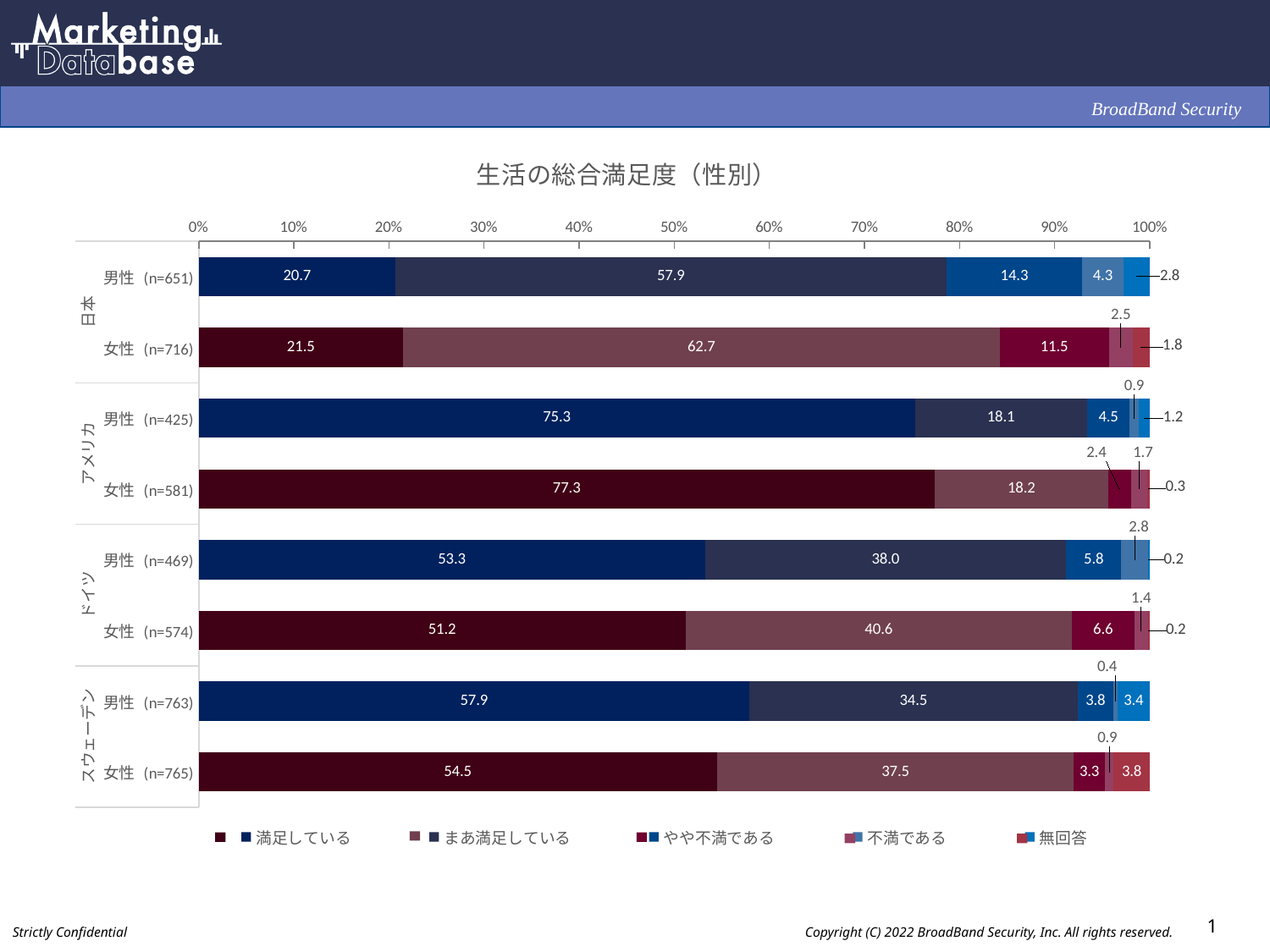
Which category has the highest 満足している value? アメリカ 女性 (n=581) What is the 満足している value for 日本 男性 (n=651)? 20.7 What is the difference between the 満足している values for ドイツ 男性 (n=469) and ドイツ 女性 (n=574)? 2.1 How many series does the legend list? 5 What is the やや不満である value for アメリカ 男性 (n=425)? 4.5 What type of chart is shown on the slide? Stacked bar chart What is the まあ満足している value for 日本 女性 (n=716)? 62.7 How many bars (category rows) are plotted in the chart? 8 Which category has the lowest 満足している value? 日本 男性 (n=651) What is the 無回答 value for スウェーデン 女性 (n=765)? 3.8 What is the title of the chart? 生活の総合満足度（性別） Which is larger, the まあ満足している value for スウェーデン 男性 (n=763) or for スウェーデン 女性 (n=765)? スウェーデン 女性 (n=765)